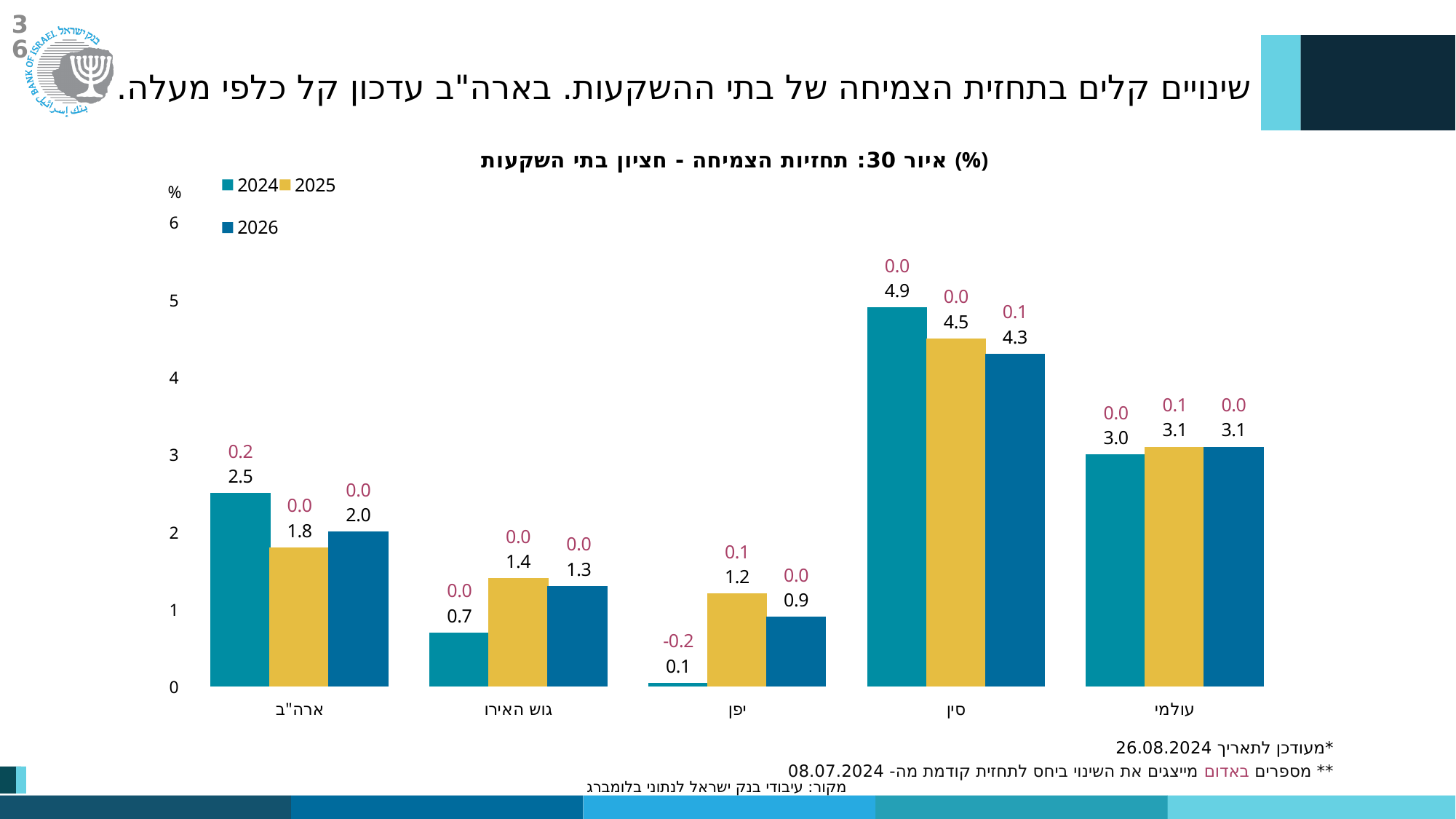
How many categories are shown on the x axis? 5 What is the red number shown above the 2024 bar for ארה"ב? 0.2 Is the 2024 value for עולמי greater or less than 2? greater What is the 2026 growth forecast for יפן? 0.9 What is the 2024 growth forecast for ארה"ב? 2.5 What is the difference between the 2024 and 2026 forecasts for סין? 0.6 Which category has the lowest 2024 value? יפן How many series does the legend list? 3 Which category has the highest 2024 value? סין What kind of chart is shown? bar chart What is the 2025 growth forecast for סין? 4.5 Which is larger for גוש האירו: the 2025 value or the 2026 value? 2025